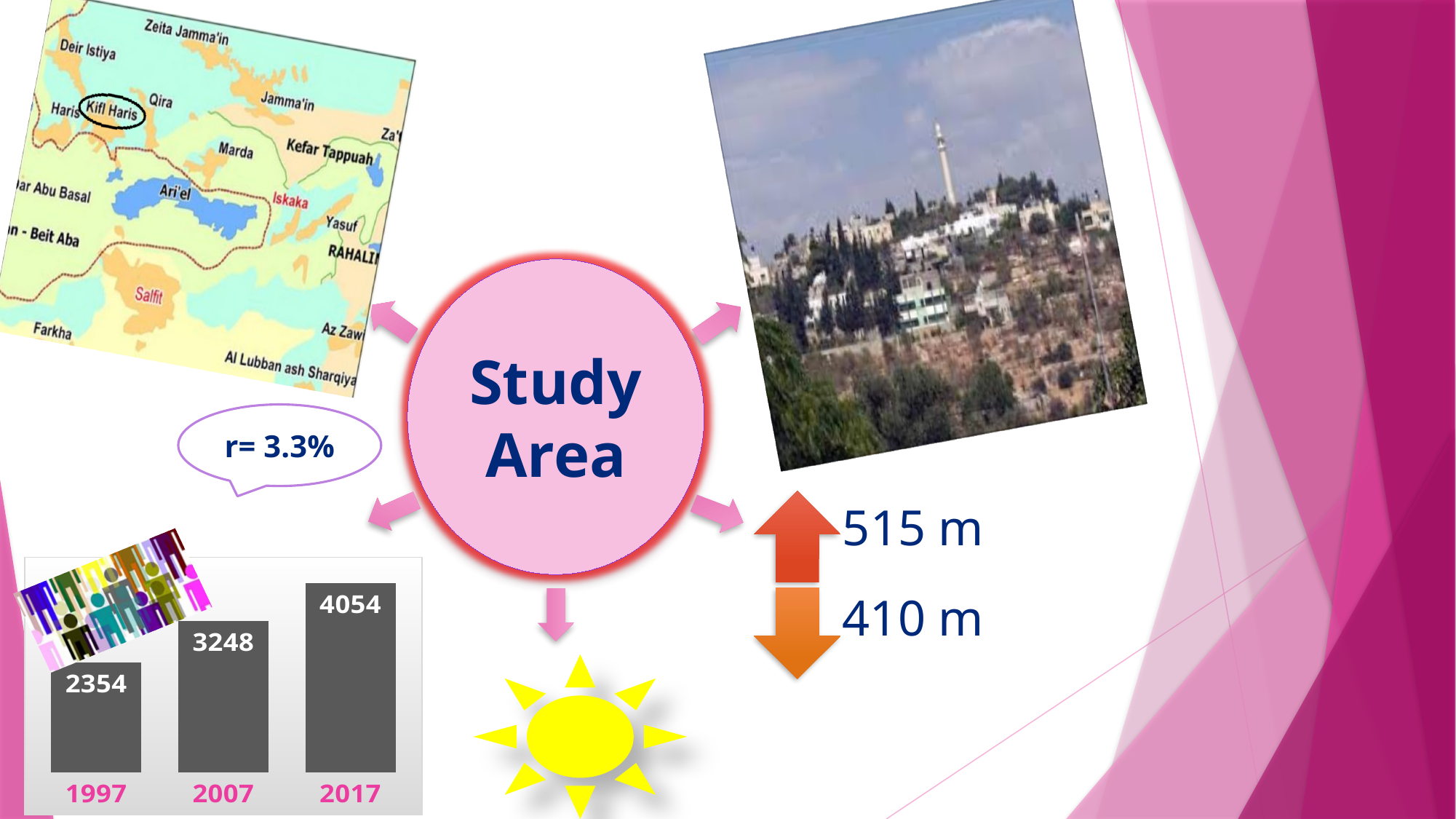
What kind of chart is shown at the bottom left of the slide? bar chart Which year has the highest value in the bar chart? 2017 What is the value shown for 2017 in the bar chart? 4054 What is the value shown for 1997 in the bar chart? 2354 What is the difference between the values for 2007 and 1997 in the bar chart? 894 What is the difference between the values for 2017 and 1997 in the bar chart? 1700 Which year has the lowest value in the bar chart? 1997 What colour are the bars in the bar chart? dark grey What is the value shown for 2007 in the bar chart? 3248 How many bars are shown in the bar chart? 3 Do the values in the bar chart rise or fall from 1997 to 2017? rise Which is larger in the bar chart, the value for 2007 or the value for 2017? 2017